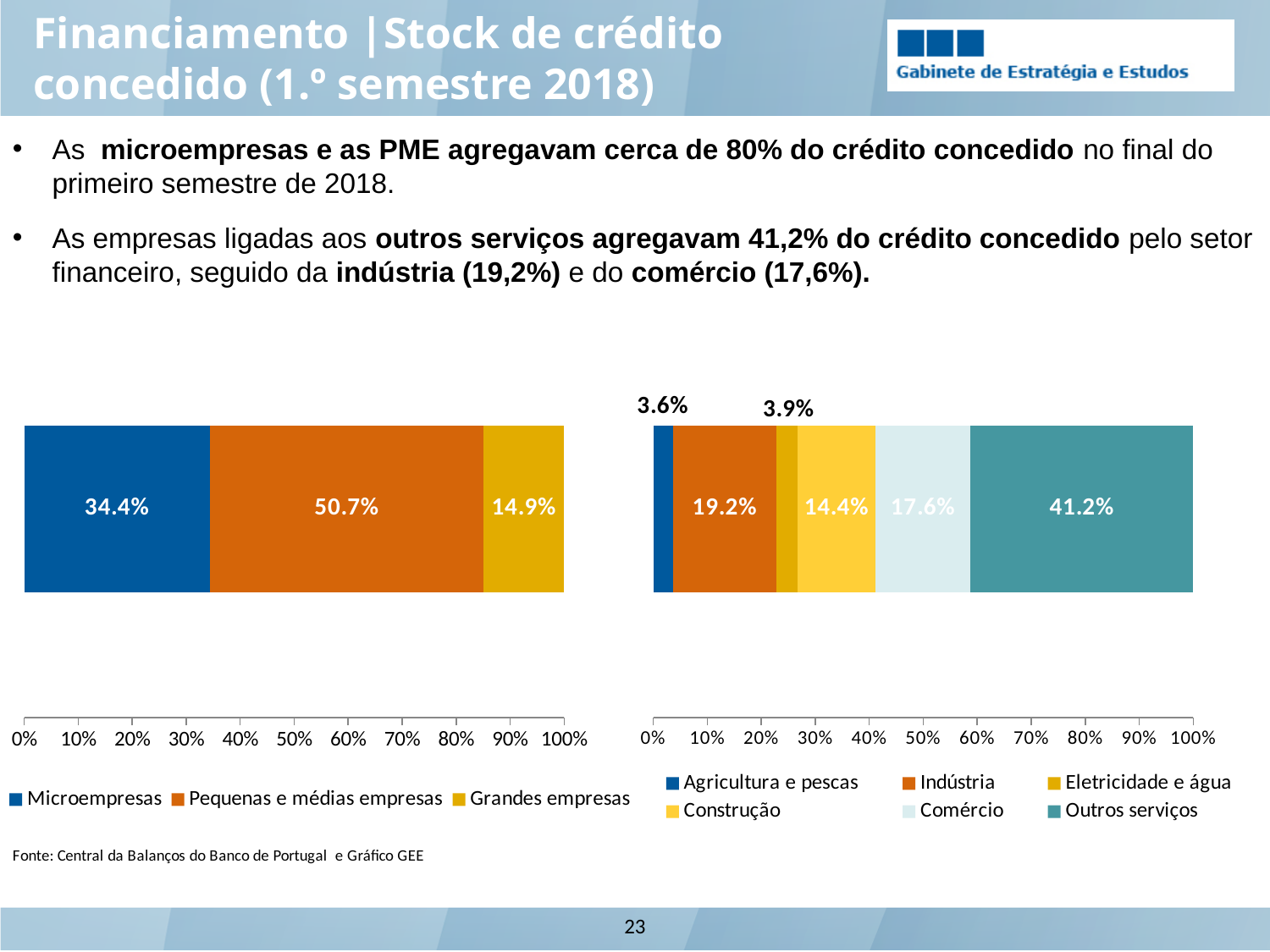
How many series does the legend of the left chart list? 3 In the right chart, what is the value for Outros serviços? 41.2% In the left chart, which series has the largest value? Pequenas e médias empresas In the right chart, which series has the smallest value? Agricultura e pescas In the right chart, what is the value for Construção? 14.4% In the right chart, which is larger, Indústria or Comércio? Indústria What kind of chart is the right chart? Stacked bar chart In the left chart, what is the value for Grandes empresas? 14.9% How many series does the legend of the right chart list? 6 In the left chart, what is the value for Pequenas e médias empresas? 50.7% In the left chart, what is the difference between Pequenas e médias empresas and Microempresas? 16.3% In the right chart, what is the combined value of Indústria and Comércio? 36.8%